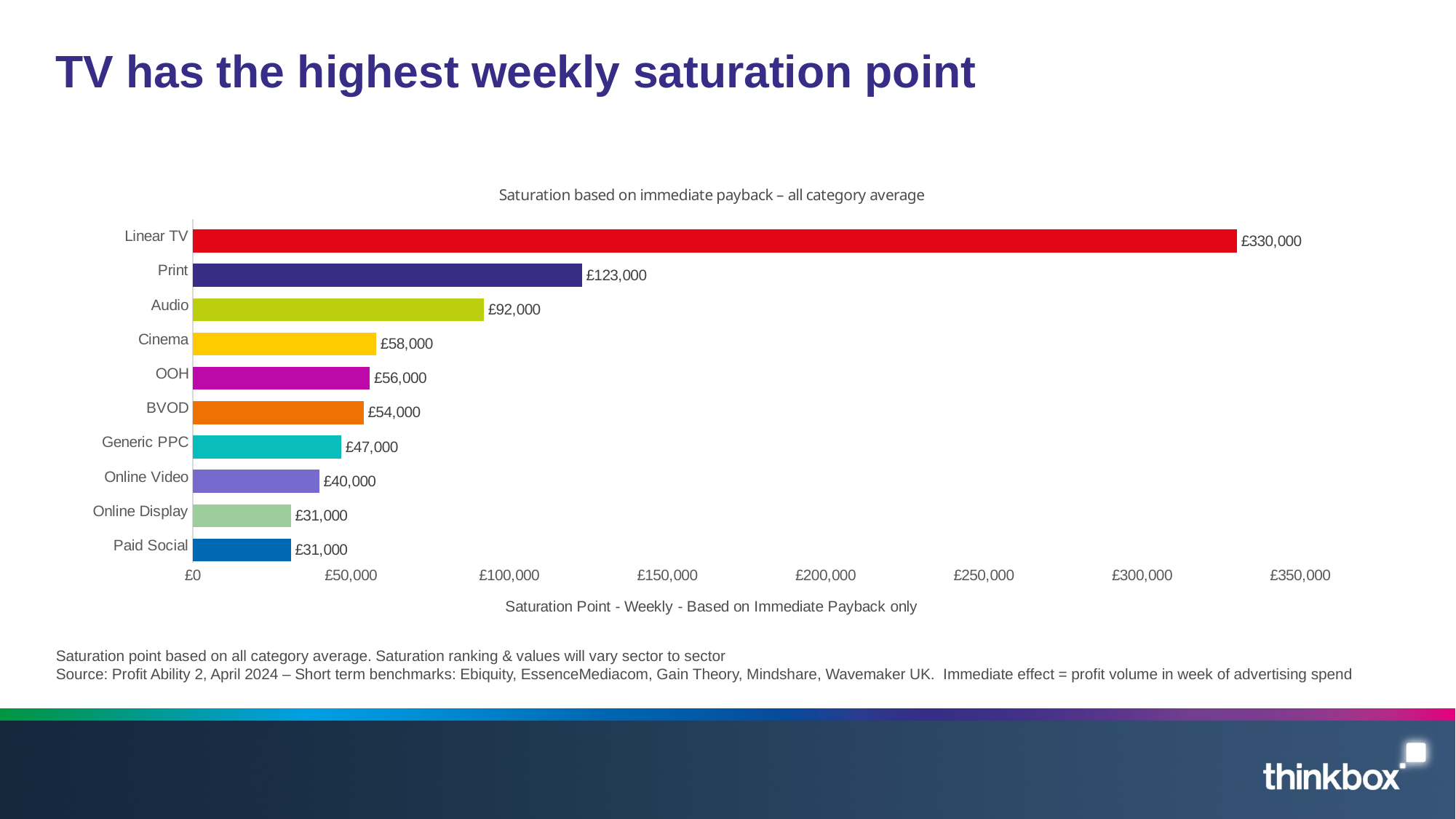
Which has a larger saturation point, BVOD or Online Video? BVOD Which category has the highest saturation point? Linear TV What is the saturation point for Audio? £92,000 What is the saturation point for Generic PPC? £47,000 What is the title of the chart? Saturation based on immediate payback – all category average Is the value for Print greater or less than £100,000? greater How many categories are shown in the chart? 10 What kind of chart is shown on the slide? Bar chart What is the difference between the saturation points of Cinema and OOH? £2,000 Which has a larger saturation point, Print or Audio? Print What is the saturation point for Linear TV? £330,000 What is the difference between the saturation points of Linear TV and Print? £207,000